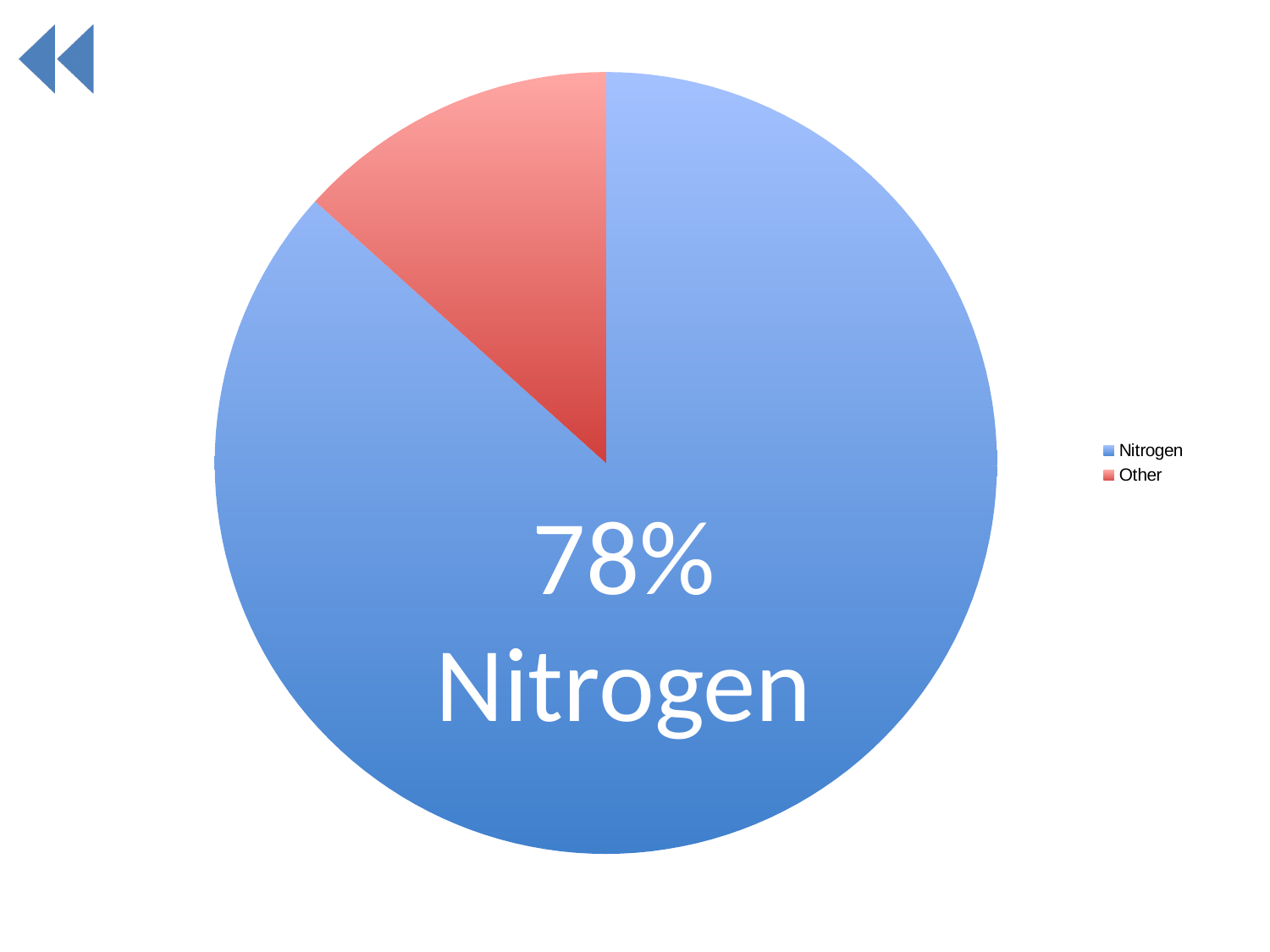
How many slices does the pie chart have? 2 What colour is the Other slice in the pie chart? Red Which slice is larger, Nitrogen or Other? Nitrogen Which slice of the pie chart is the largest? Nitrogen Which slice of the pie chart is the smallest? Other What percentage is printed on the Nitrogen slice of the pie chart? 78% What share of the pie does the Nitrogen slice represent? 78% What kind of chart is shown on the slide? Pie chart What colour is the Nitrogen slice in the pie chart? Blue How many entries does the legend list? 2